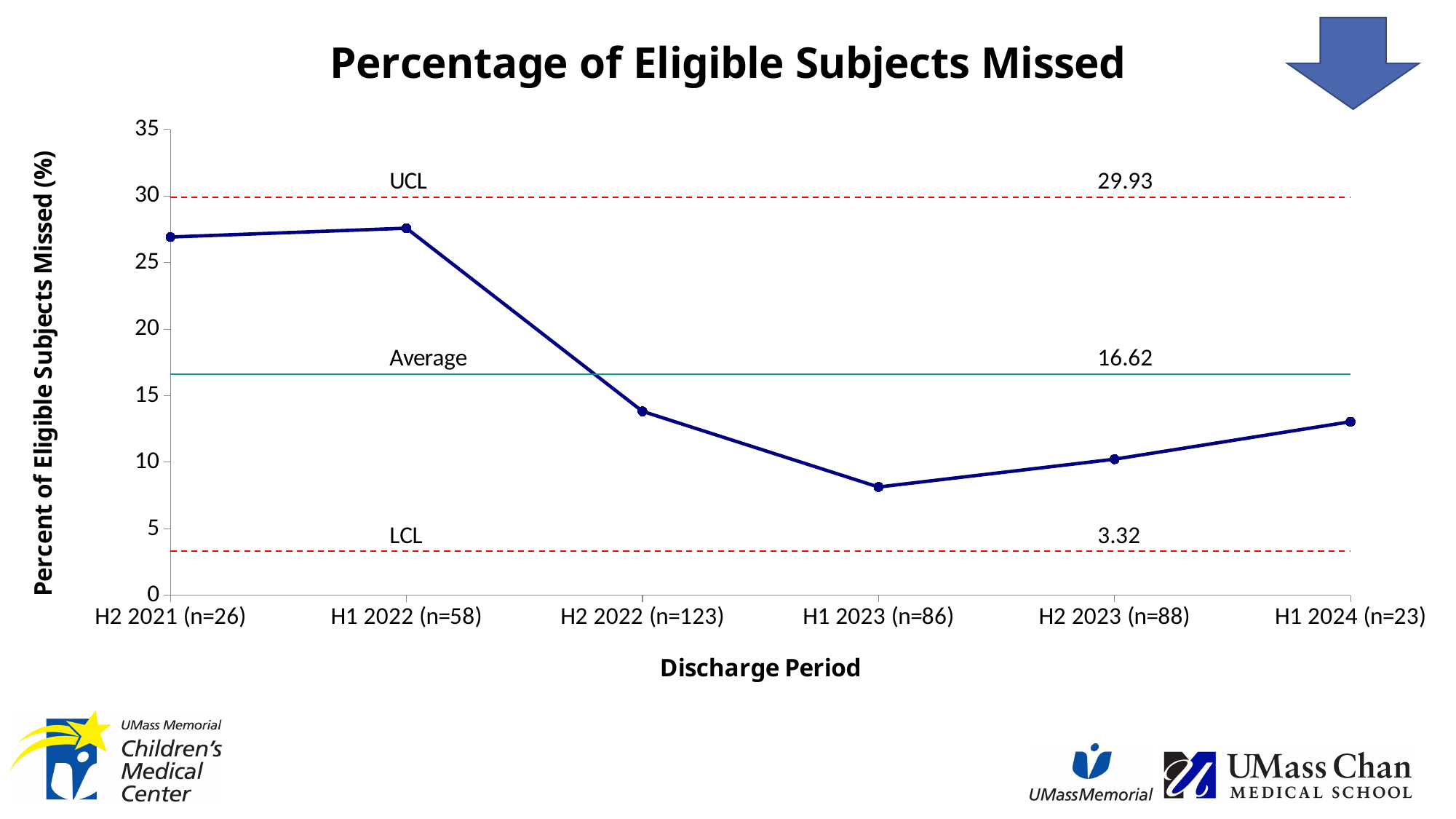
What kind of chart is shown on the slide? line chart Do the values rise or fall from H1 2022 (n=58) to H1 2023 (n=86)? fall What is the value of the Average line? 16.62 What is the label of the x axis? Discharge Period What is the value of the LCL line? 3.32 Is the value for H1 2023 (n=86) greater or less than 10? less What is the value of the UCL line? 29.93 How many discharge periods are plotted on the x axis? 6 What is the difference between the UCL and the LCL values? 26.61 Is the value for H2 2021 (n=26) greater or less than 25? greater Which is larger, the value for H2 2022 (n=123) or the value for H1 2023 (n=86)? H2 2022 (n=123) Which discharge period has the lowest percentage of eligible subjects missed? H1 2023 (n=86)